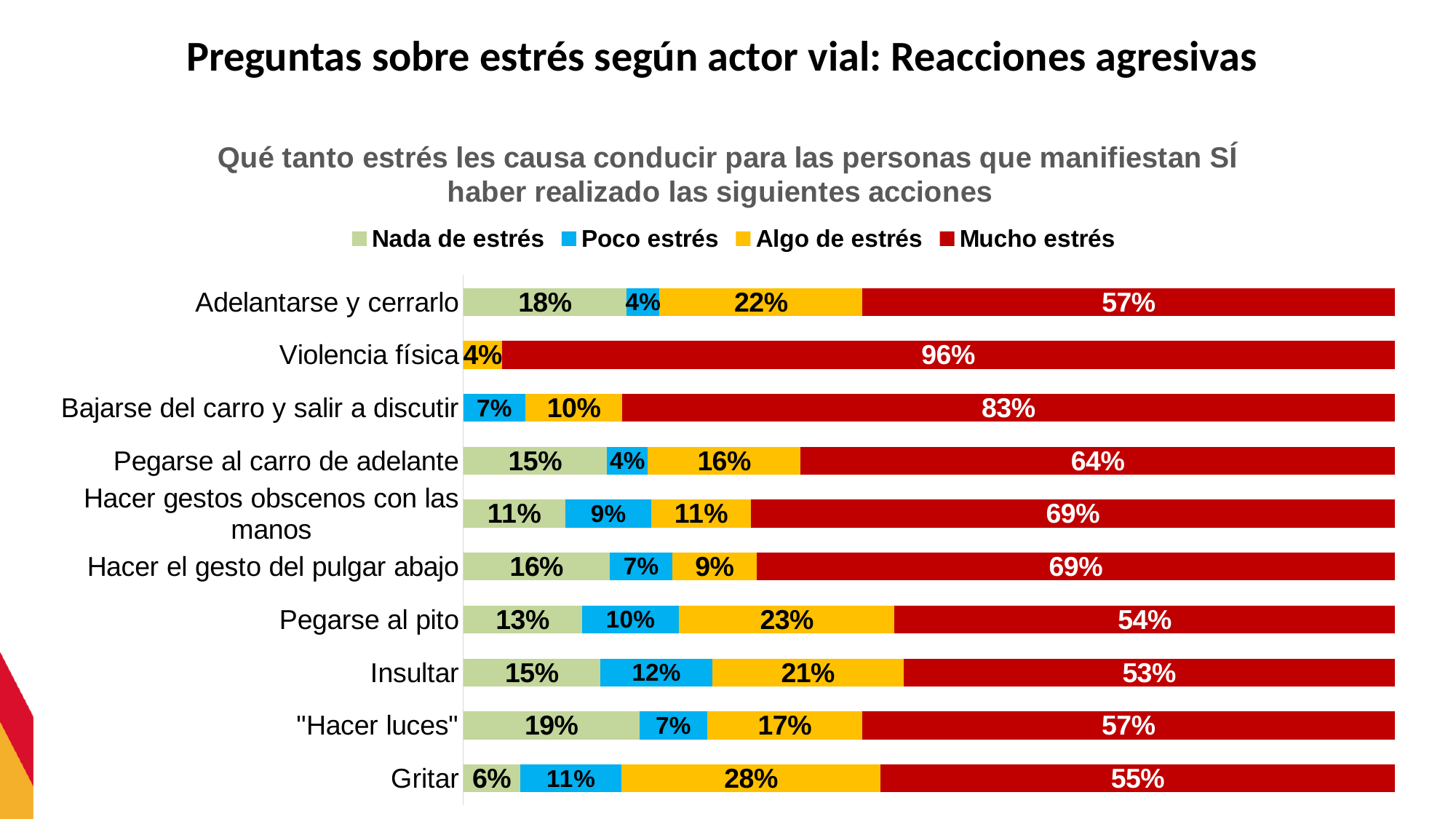
What is the 'Poco estrés' value for 'Insultar'? 12% How many categories (actions) are plotted on the chart? 10 Which category has the highest 'Mucho estrés' value? Violencia física Which colour represents 'Mucho estrés' in the legend? Red What is the difference between the 'Mucho estrés' values for 'Bajarse del carro y salir a discutir' and 'Pegarse al carro de adelante'? 19% What is the 'Nada de estrés' value for '"Hacer luces"'? 19% How many series does the legend list? 4 Which is larger: the 'Algo de estrés' value for 'Pegarse al pito' or for 'Adelantarse y cerrarlo'? Pegarse al pito What kind of chart is shown on the slide? Stacked bar chart Which category has the lowest 'Mucho estrés' value? Insultar What is the 'Algo de estrés' value for 'Gritar'? 28% What is the 'Mucho estrés' value for 'Violencia física'? 96%